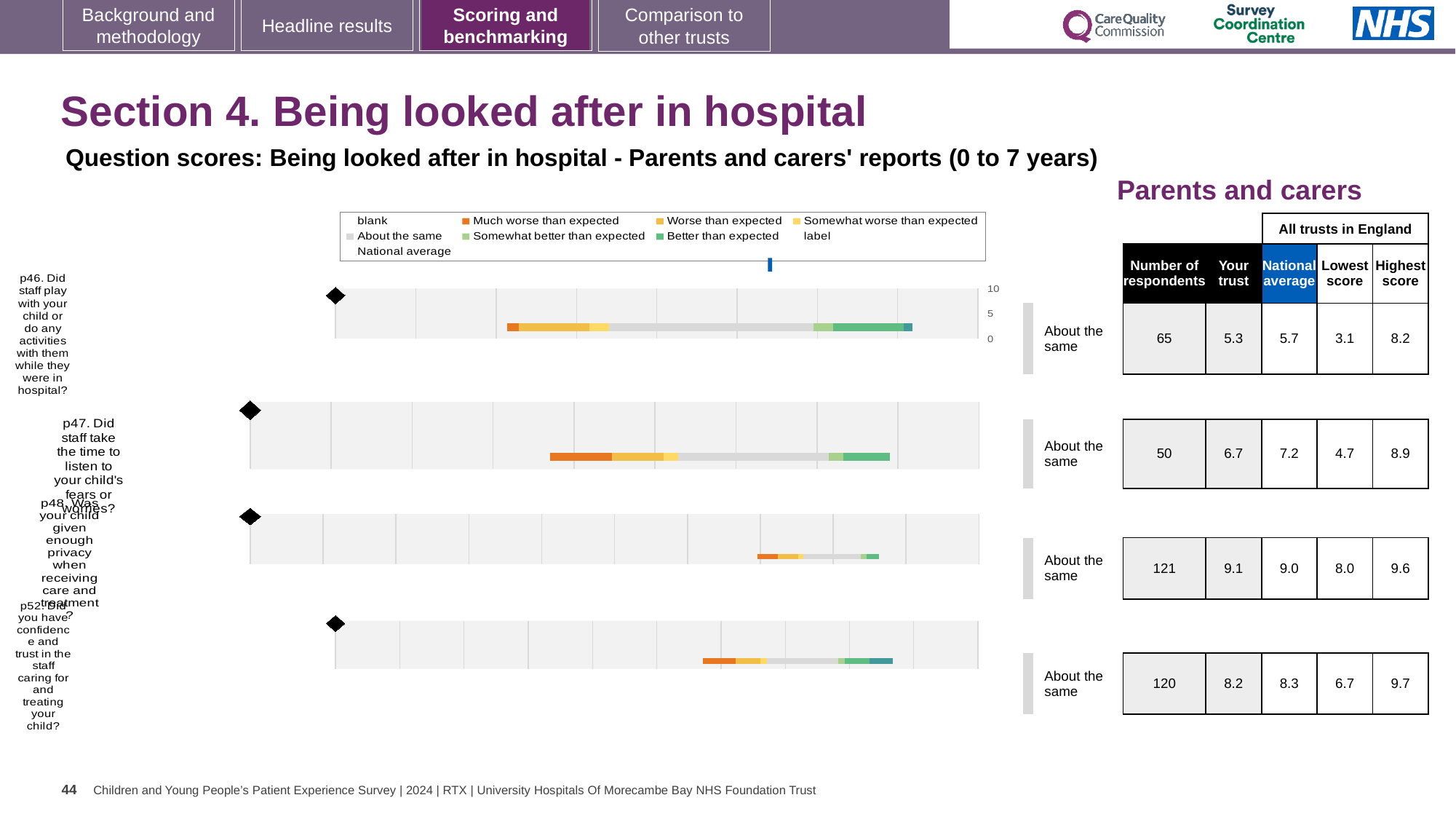
Which question has the lowest 'Your trust' score? p46 How many survey questions (bars) are plotted on the slide? 4 For p47, what is the difference between the national average and the 'Your trust' score? 0.5 For p46, what is the national average score? 5.7 For p52 (Did you have confidence and trust in the staff caring for and treating your child?), what is the 'Your trust' score? 8.2 For p46 (Did staff play with your child or do any activities with them while they were in hospital?), what is the 'Your trust' score? 5.3 What kind of chart is used to show the question scores on this slide? bar chart For p47, what is the highest score among all trusts in England? 8.9 What benchmark category is shown for all four questions on the slide? About the same How many respondents answered p47 (Did staff take the time to listen to your child's fears or worries?)? 50 For p48 (Was your child given enough privacy when receiving care and treatment?), what is the lowest score among all trusts in England? 8.0 Which question has the highest 'Your trust' score? p48